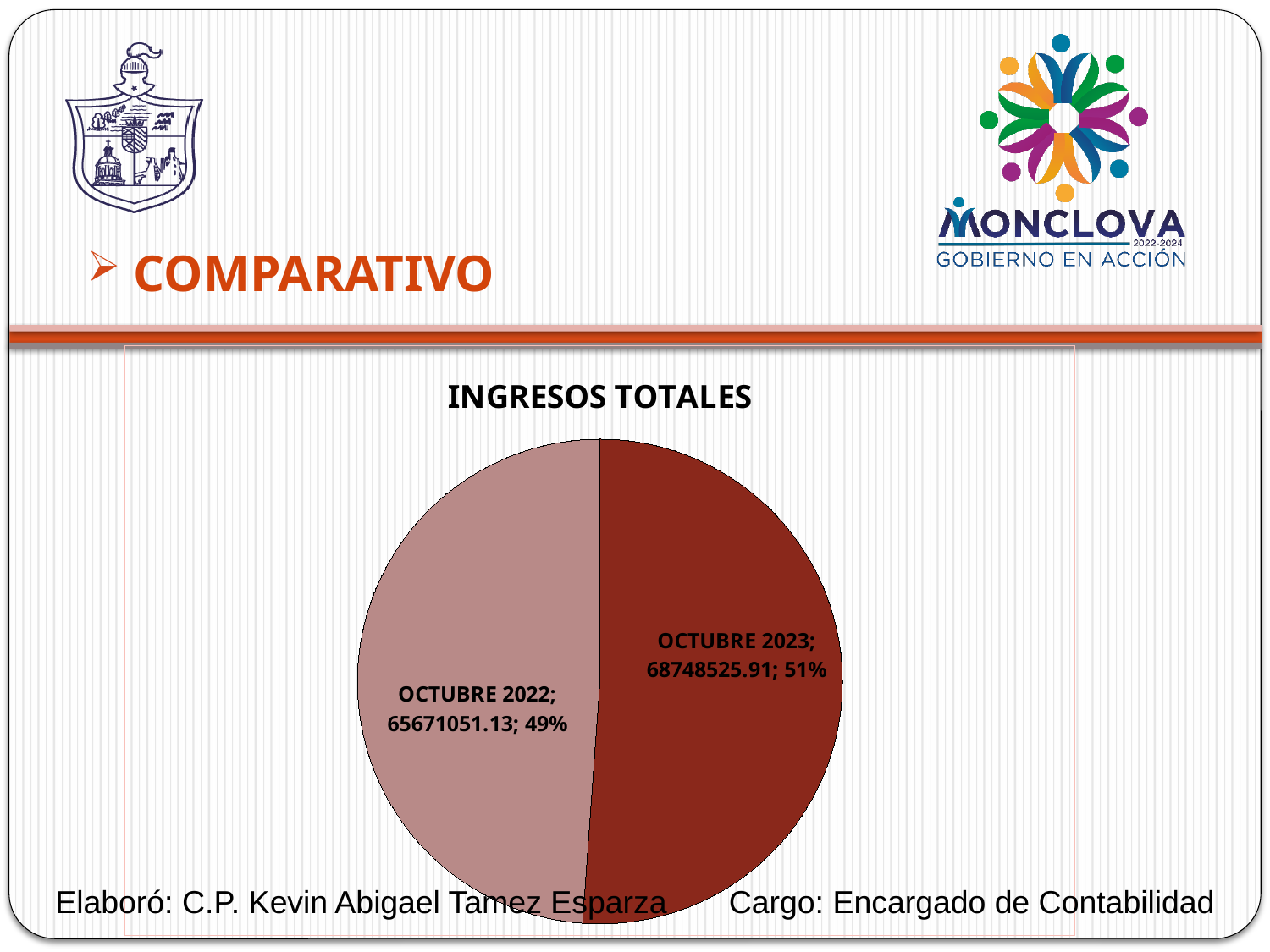
What is the title of the chart? INGRESOS TOTALES How many slices does the pie chart have? 2 What is the value for OCTUBRE 2022? 65671051.13 Which slice is the smallest? OCTUBRE 2022 What share of the pie does OCTUBRE 2022 represent? 49% What is the difference between the values for OCTUBRE 2023 and OCTUBRE 2022? 3077474.78 What kind of chart is shown on the slide? pie chart What is the total of the two values shown in the pie chart? 134419577.04 What share of the pie does OCTUBRE 2023 represent? 51% Which slice is the largest? OCTUBRE 2023 What is the value for OCTUBRE 2023? 68748525.91 Which is larger, the value for OCTUBRE 2022 or OCTUBRE 2023? OCTUBRE 2023